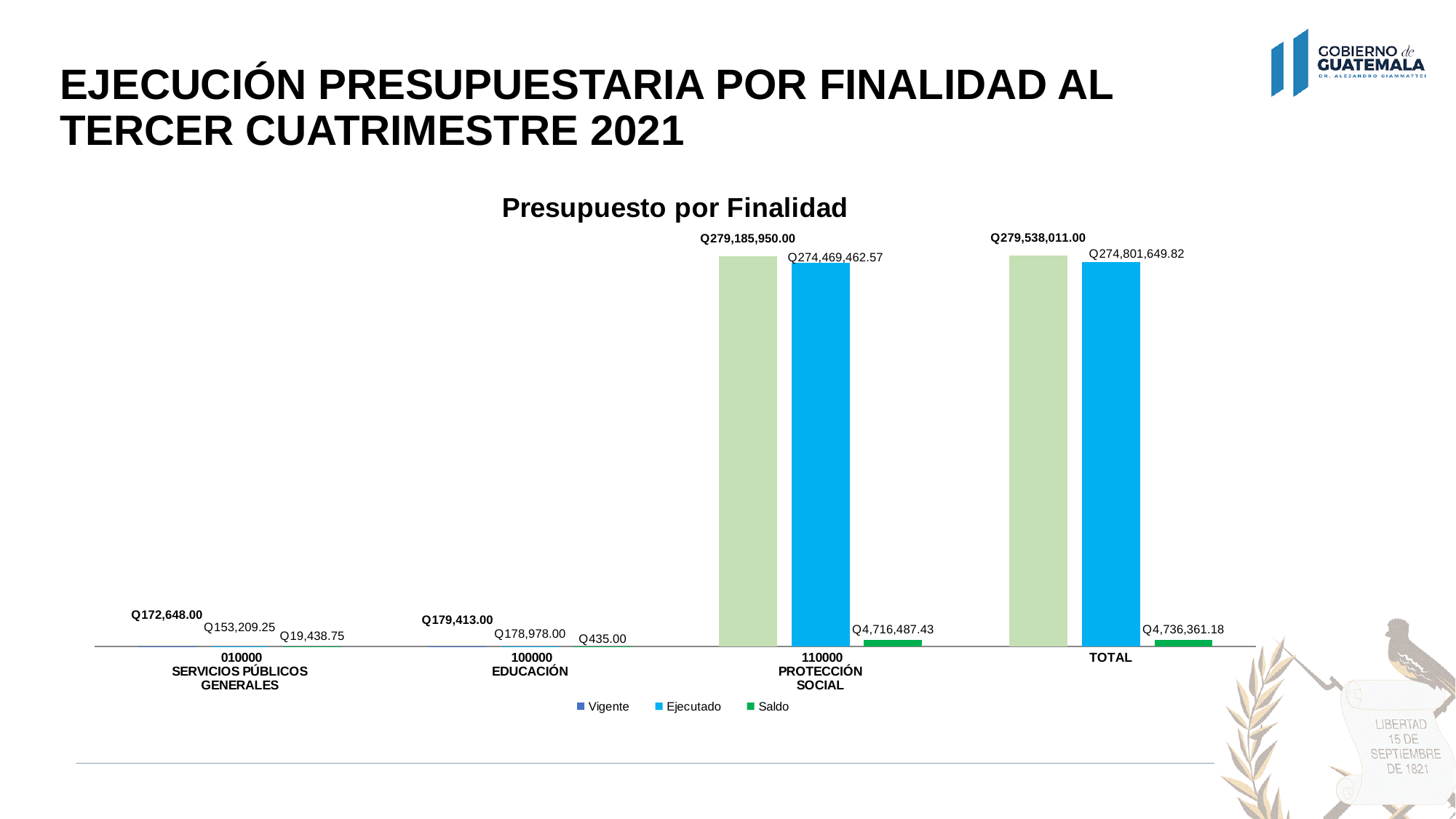
What is the Ejecutado value for 010000 SERVICIOS PÚBLICOS GENERALES? Q153,209.25 How many series does the legend list? 3 Excluding TOTAL, which finalidad has the highest Vigente value? 110000 PROTECCIÓN SOCIAL What type of chart is shown on the slide? Bar chart Which is larger, the Ejecutado value for 100000 EDUCACIÓN or the Ejecutado value for 010000 SERVICIOS PÚBLICOS GENERALES? 100000 EDUCACIÓN What is the Saldo value for 110000 PROTECCIÓN SOCIAL? Q4,716,487.43 What is the difference between the Vigente and Ejecutado values for 010000 SERVICIOS PÚBLICOS GENERALES? Q19,438.75 What is the Vigente value for 110000 PROTECCIÓN SOCIAL? Q279,185,950.00 What is the Ejecutado value for TOTAL? Q274,801,649.82 What is the Saldo value for 100000 EDUCACIÓN? Q435.00 Excluding TOTAL, which finalidad has the lowest Saldo value? 100000 EDUCACIÓN How many categories are shown on the x axis of the chart? 4